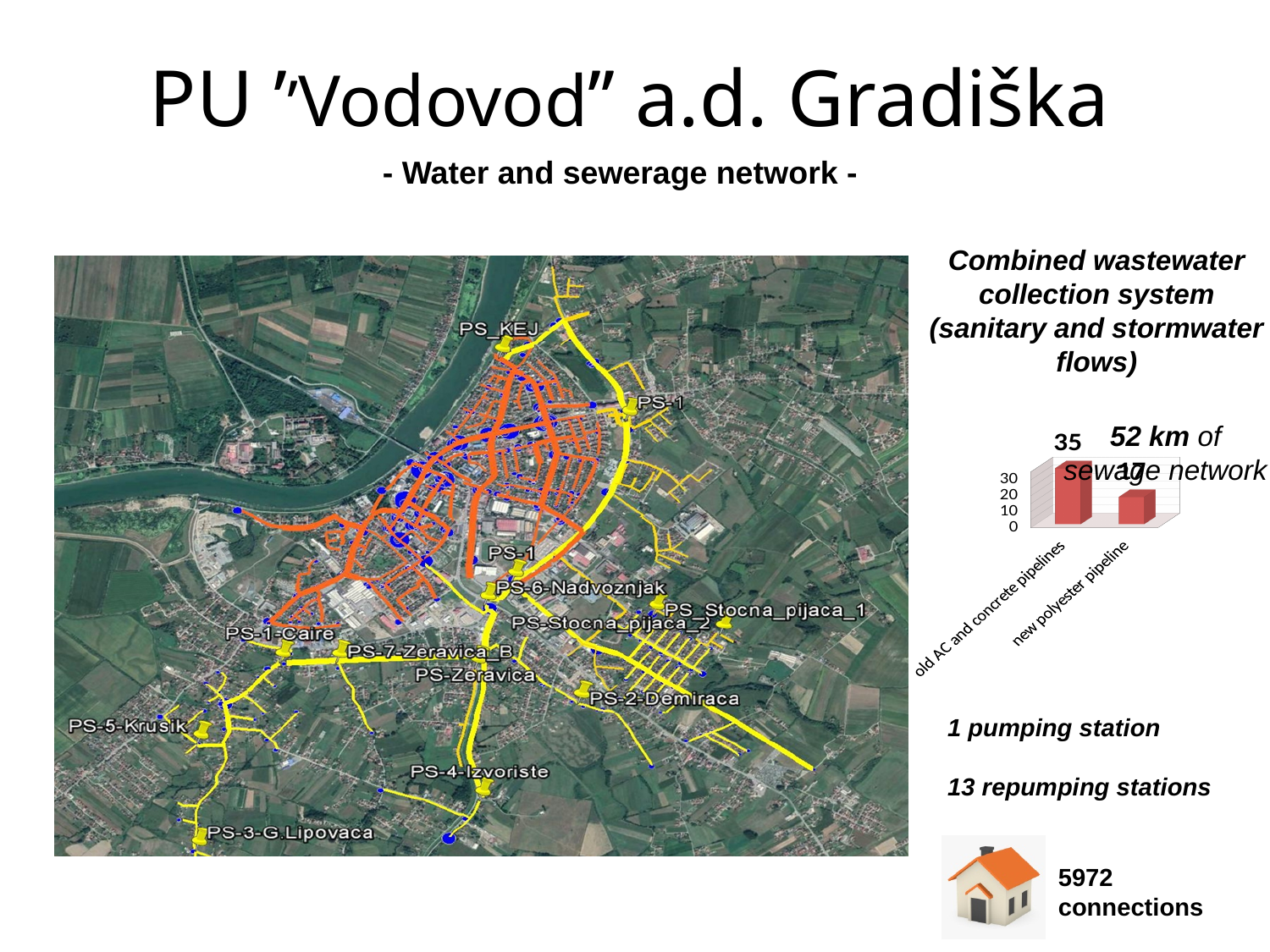
How many categories are shown in the bar chart? 2 Which is larger: the value for old AC and concrete pipelines or the value for new polyester pipeline? old AC and concrete pipelines What is the total of the two values shown in the bar chart? 52 Is the value for new polyester pipeline greater or less than 20? less Is the value for old AC and concrete pipelines greater or less than 30? greater What kind of chart is shown on the slide? bar chart Which category has the lowest value in the bar chart? new polyester pipeline What value is shown for new polyester pipeline in the bar chart? 17 What is the highest tick value shown on the vertical axis of the bar chart? 30 What value is shown for old AC and concrete pipelines in the bar chart? 35 What is the difference between the values for old AC and concrete pipelines and new polyester pipeline? 18 Which category has the highest value in the bar chart? old AC and concrete pipelines